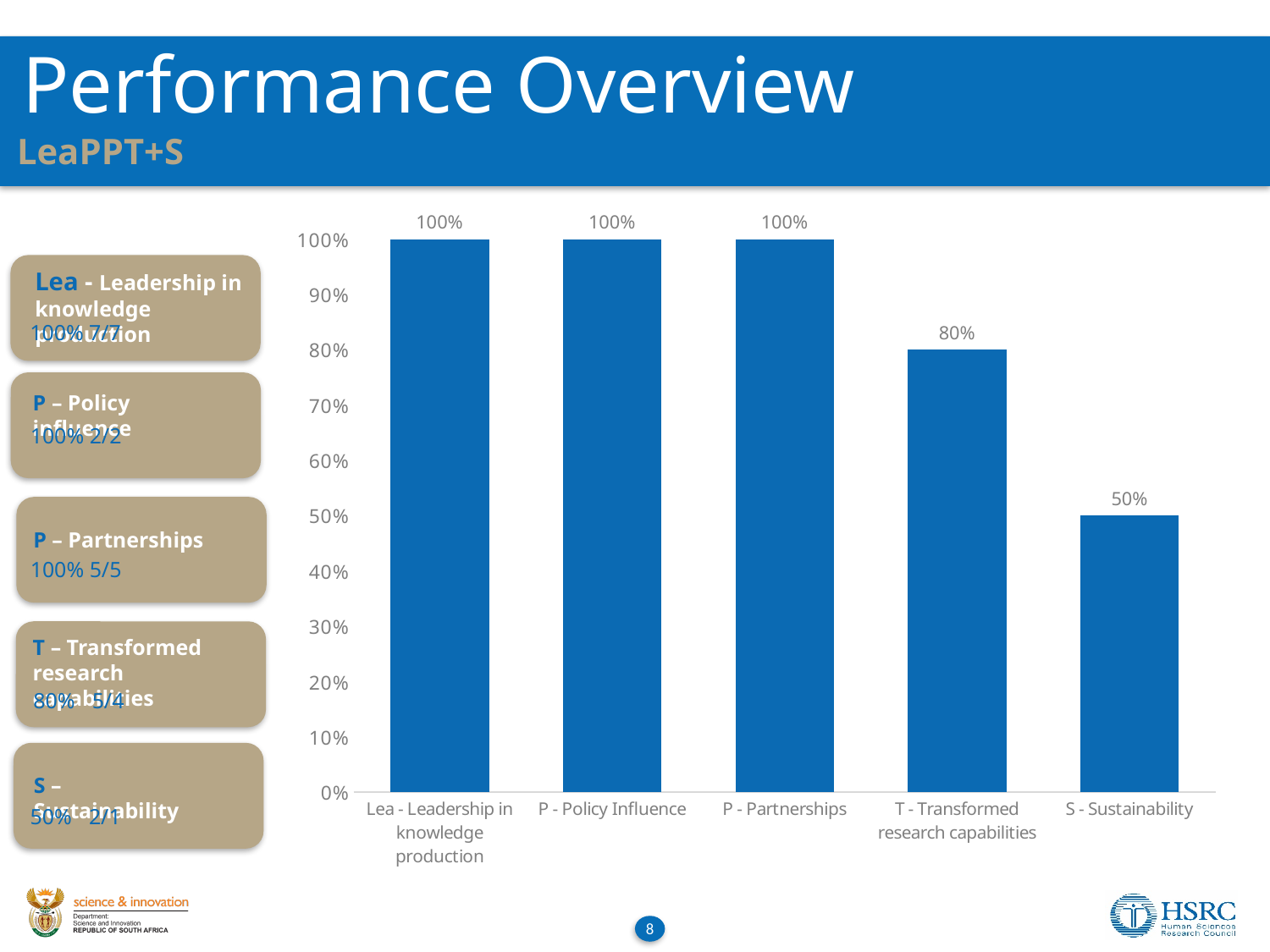
What is the difference between the values for P - Partnerships and T - Transformed research capabilities? 20% How many categories have a value of 100%? 3 Which category has the lowest value? S - Sustainability What is the value for P - Policy Influence? 100% How many categories are shown on the x axis? 5 What is the difference between the values for T - Transformed research capabilities and S - Sustainability? 30% Do the values rise or fall from left to right along the x axis? fall What is the value for T - Transformed research capabilities? 80% Is the value for S - Sustainability greater or less than 60%? less What is the value for S - Sustainability? 50% Which is larger, the value for T - Transformed research capabilities or the value for S - Sustainability? T - Transformed research capabilities What kind of chart is shown on the slide? bar chart